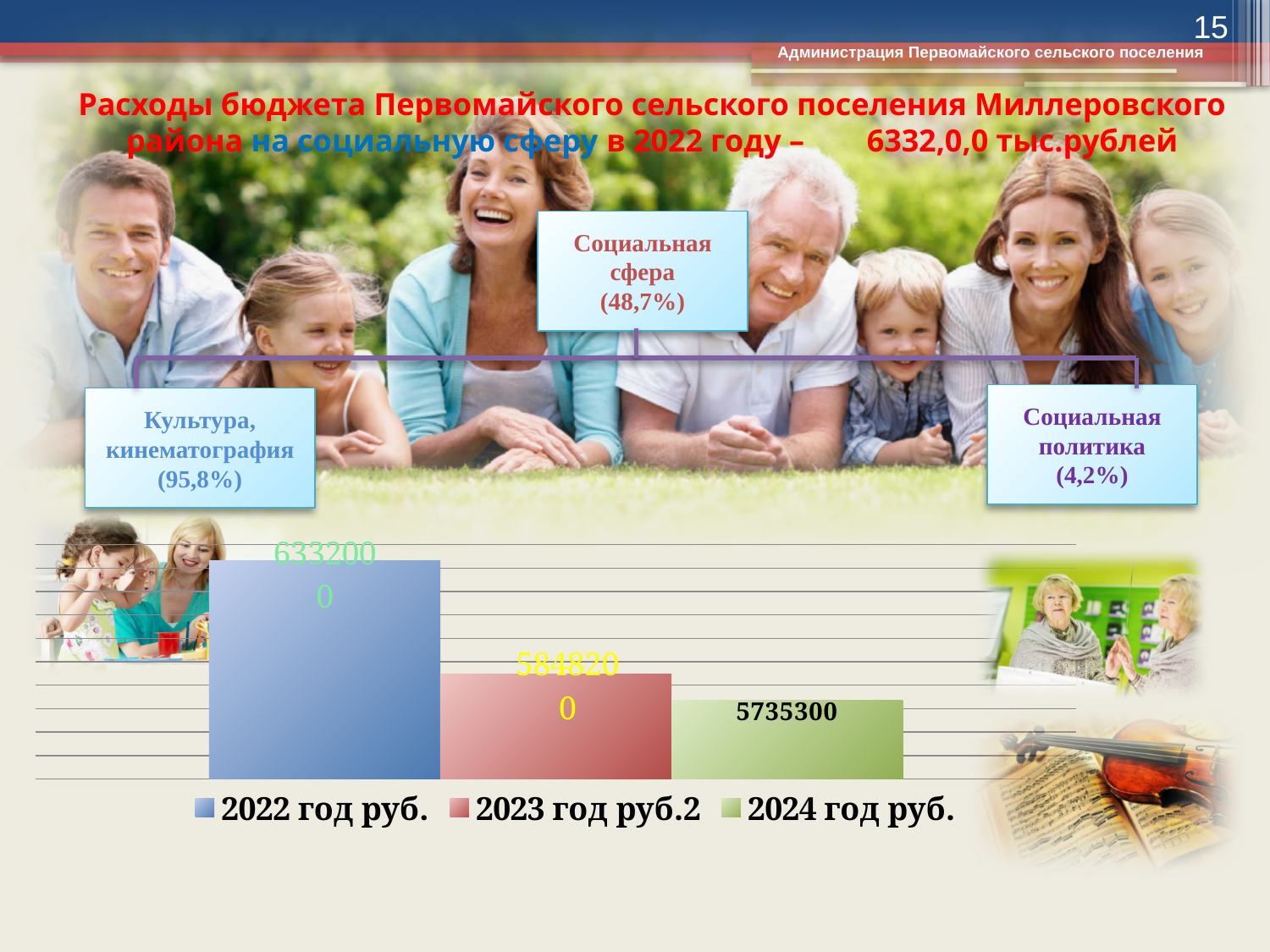
What type of chart is shown on the slide? bar chart How many series does the chart legend list? 3 What is the value shown for the series "2022 год руб."? 6332000 What is the difference between the values for "2023 год руб.2" and "2024 год руб."? 112900 Which series has the highest value in the chart? 2022 год руб. Which is larger, the value for "2022 год руб." or the value for "2024 год руб."? 2022 год руб. What is the difference between the values for "2022 год руб." and "2023 год руб.2"? 483800 Which series has the lowest value in the chart? 2024 год руб. What is the value shown for the series "2024 год руб."? 5735300 Do the values rise or fall from the 2022 bar to the 2024 bar? fall What colour is the bar for the series "2023 год руб.2"? red What is the value shown for the series "2023 год руб.2"? 5848200